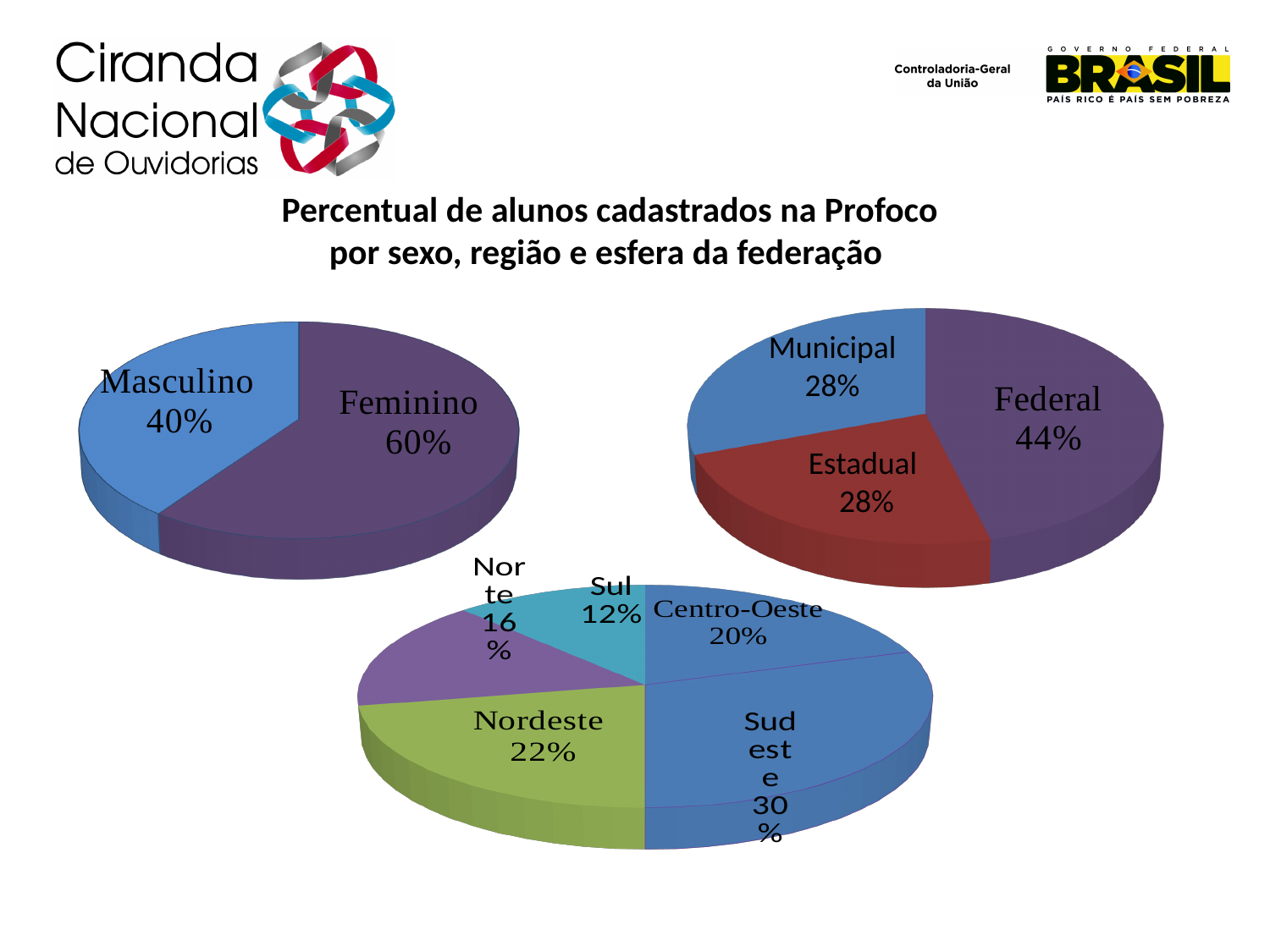
In the pie chart on the left (by sex), what is the difference between the Feminino and Masculino shares? 20% In the pie chart on the right (by esfera da federação), which category has the largest share? Federal In the pie chart on the right (by esfera da federação), how many categories are shown? 3 In the pie chart at the bottom (by region), which region has the smallest share? Sul In the pie chart at the bottom (by region), how many regions are shown? 5 In the pie chart at the bottom (by region), what is the share for Nordeste? 22% In the pie chart on the left (by sex), what is the share for Masculino? 40% What kind of charts are shown on the slide? Pie charts In the pie chart on the left (by sex), what is the share for Feminino? 60% In the pie chart on the right (by esfera da federação), what is the difference between the Federal and Estadual shares? 16% In the pie chart on the right (by esfera da federação), what is the share for Federal? 44% In the pie chart at the bottom (by region), which region has the largest share? Sudeste